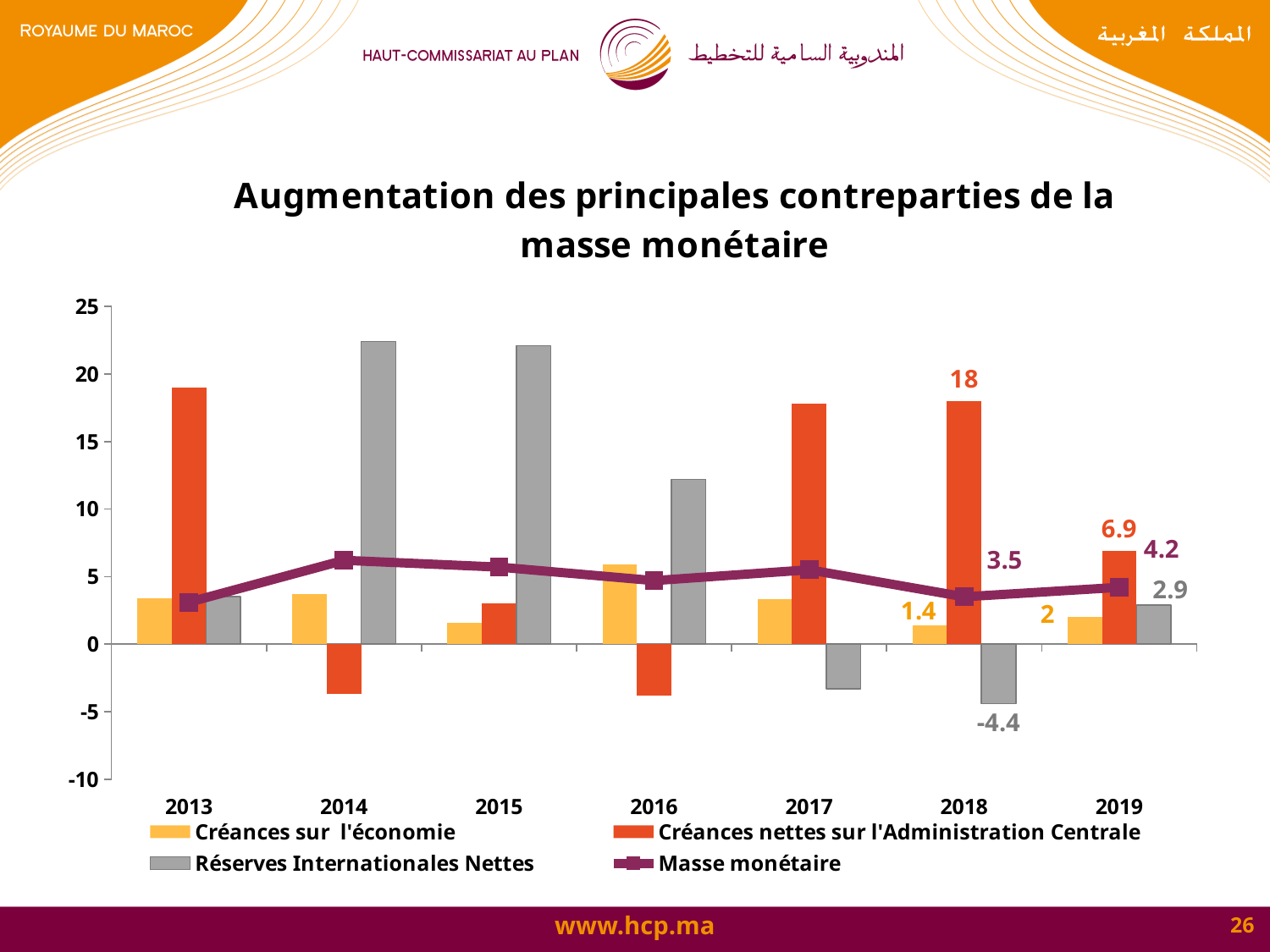
By how much did Créances nettes sur l'Administration Centrale fall from 2018 to 2019? 11.1 What is the value of Créances sur l'économie in 2019? 2 How many years are shown on the x axis? 7 What is the title of the chart? Augmentation des principales contreparties de la masse monétaire In 2019, which is larger: Masse monétaire or Réserves Internationales Nettes? Masse monétaire Is the value for Réserves Internationales Nettes in 2014 greater or less than 20? greater What is the value of Réserves Internationales Nettes in 2018? -4.4 Is the value for Créances nettes sur l'Administration Centrale in 2013 greater or less than 15? greater What is the value of Créances nettes sur l'Administration Centrale in 2018? 18 How many series does the legend list? 4 In which year is Réserves Internationales Nettes at its lowest? 2018 What is the value of Masse monétaire in 2019? 4.2